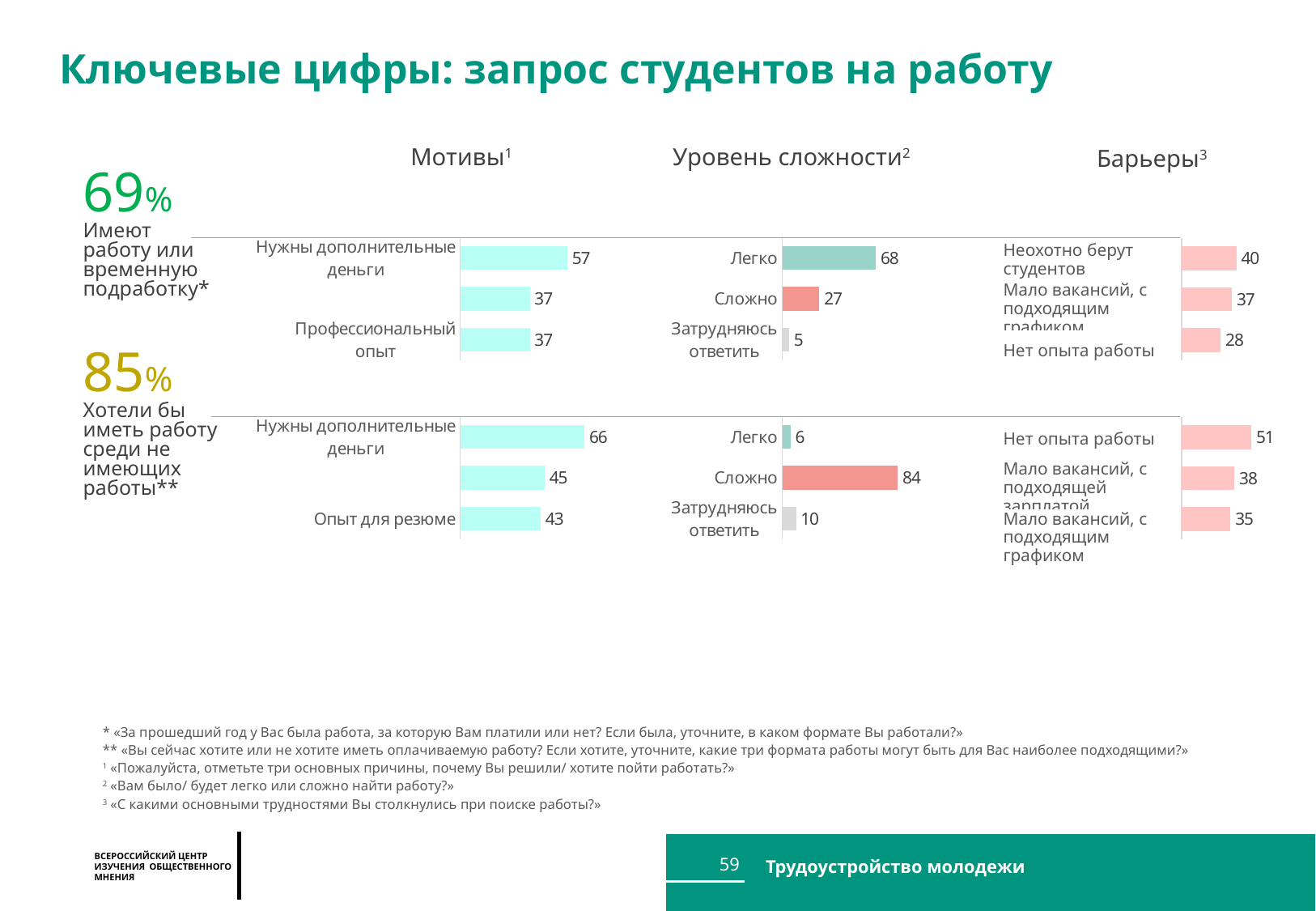
In the 'Барьеры' chart for the top row, what is the difference between 'Неохотно берут студентов' and 'Нет опыта работы'? 12 In the 'Уровень сложности' chart for the top row, which category has the lowest value? Затрудняюсь ответить In the 'Мотивы' chart for the top row, what is the value for 'Нужны дополнительные деньги'? 57 In the 'Мотивы' chart for the bottom row, what is the value for 'Опыт для резюме'? 43 What percentage of students have a job or temporary part-time work, according to the slide? 69% What type of chart is used in the 'Мотивы' section? Bar chart In the 'Мотивы' chart for the bottom row, which is larger: 'Нужны дополнительные деньги' or 'Опыт для резюме'? Нужны дополнительные деньги In the 'Уровень сложности' chart for the bottom row, what is the difference between 'Сложно' and 'Легко'? 78 In the 'Уровень сложности' chart for the top row (those who have a job), what is the value for 'Легко'? 68 How many bars are in the 'Барьеры' chart for the bottom row? 3 In the 'Барьеры' chart for the bottom row, which category has the highest value? Нет опыта работы In the 'Уровень сложности' chart for the bottom row (those who would like a job), what is the value for 'Сложно'? 84